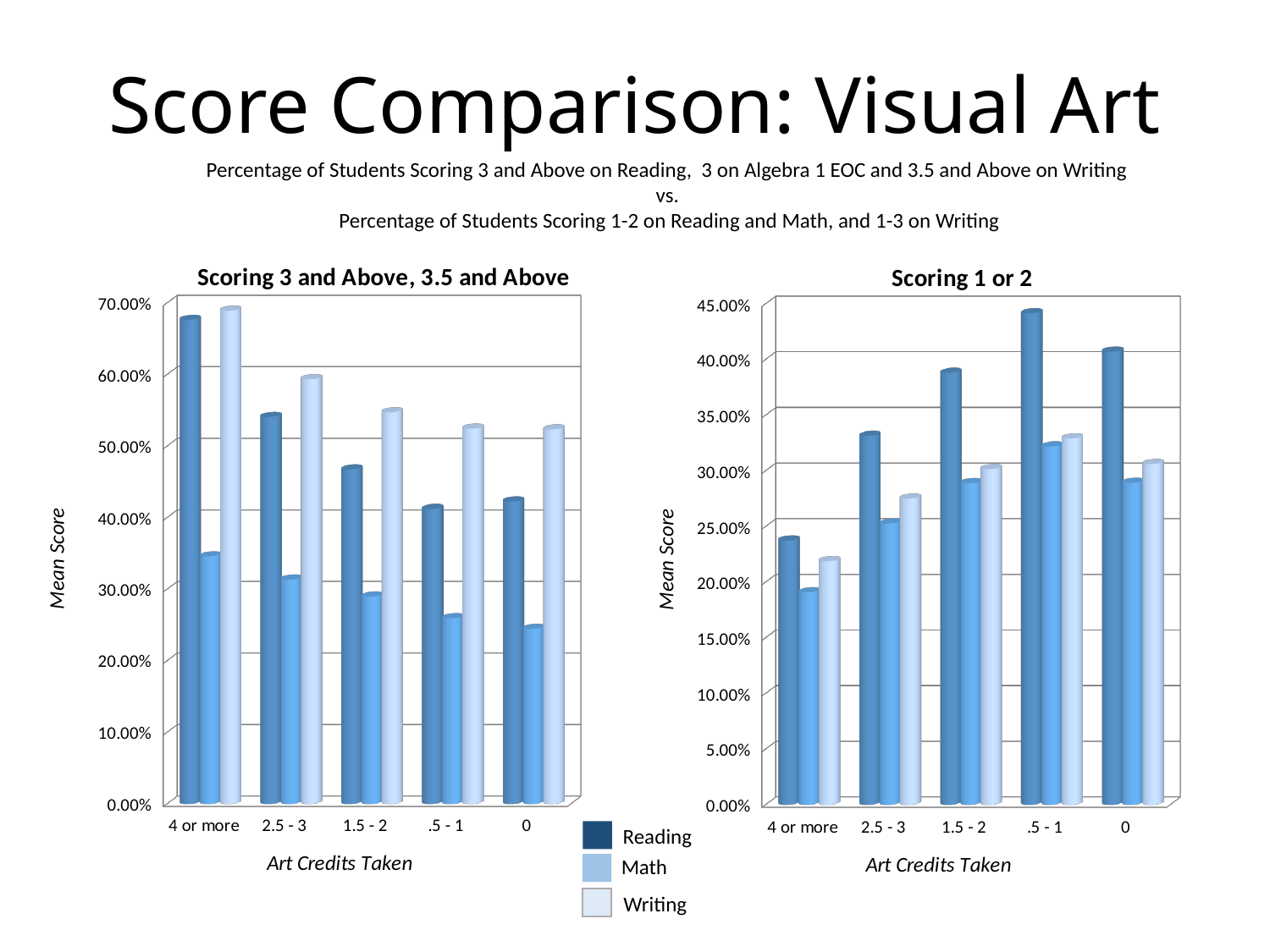
In the 'Scoring 1 or 2' chart, is the Reading value for '.5 - 1' greater or less than 40.00%? greater How many series does the legend list for the charts on this slide? 3 In the 'Scoring 3 and Above, 3.5 and Above' chart, which category has the lowest Math value? 0 In the 'Scoring 3 and Above, 3.5 and Above' chart, which is larger for '2.5 - 3': the Reading value or the Writing value? Writing In the 'Scoring 3 and Above, 3.5 and Above' chart, is the Reading value for '4 or more' greater or less than 60.00%? greater What kind of chart is the 'Scoring 3 and Above, 3.5 and Above' chart? bar chart What is the label on the x axis of the 'Scoring 1 or 2' chart? Art Credits Taken In the 'Scoring 1 or 2' chart, do the Math values rise or fall from '4 or more' to '.5 - 1'? rise In the 'Scoring 1 or 2' chart, which category has the highest Reading value? .5 - 1 In the 'Scoring 1 or 2' chart, is the Math value for '4 or more' greater or less than 20.00%? less How many categories are shown on the x axis of the 'Scoring 1 or 2' chart? 5